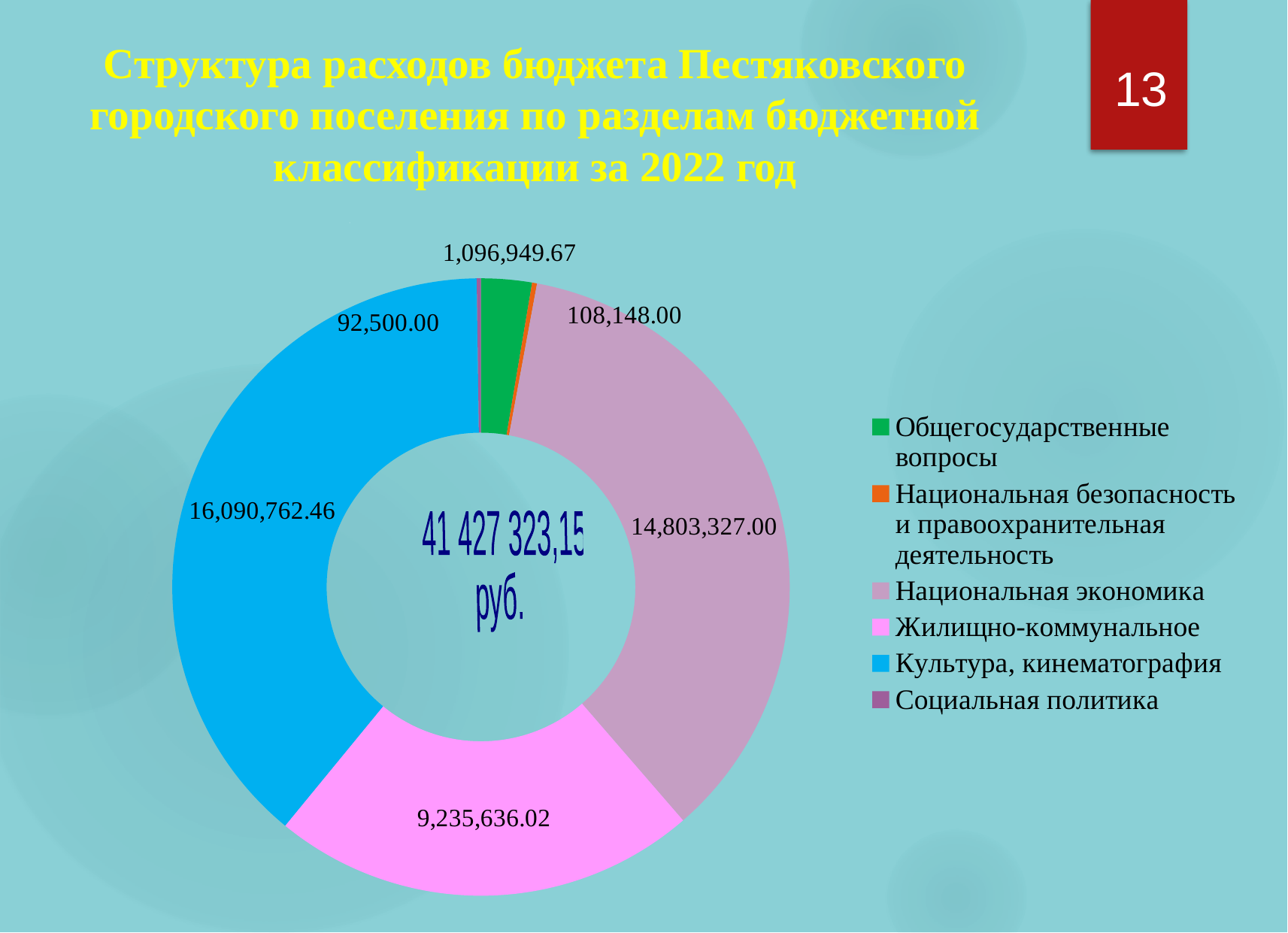
Which category has the smallest value? Социальная политика What is the value for Культура, кинематография? 16,090,762.46 Which is larger: Национальная экономика or Жилищно-коммунальное? Национальная экономика What is the difference between the values for Культура, кинематография and Национальная экономика? 1,287,435.46 What is the value for Социальная политика? 92,500.00 What is the value for Национальная экономика? 14,803,327.00 What is the value for Жилищно-коммунальное? 9,235,636.02 What is the value for Общегосударственные вопросы? 1,096,949.67 How many categories does the legend list? 6 What kind of chart is shown on the slide? Doughnut (pie) chart What total is shown in the centre of the chart? 41 427 323,15 руб. Which category has the largest value? Культура, кинематография